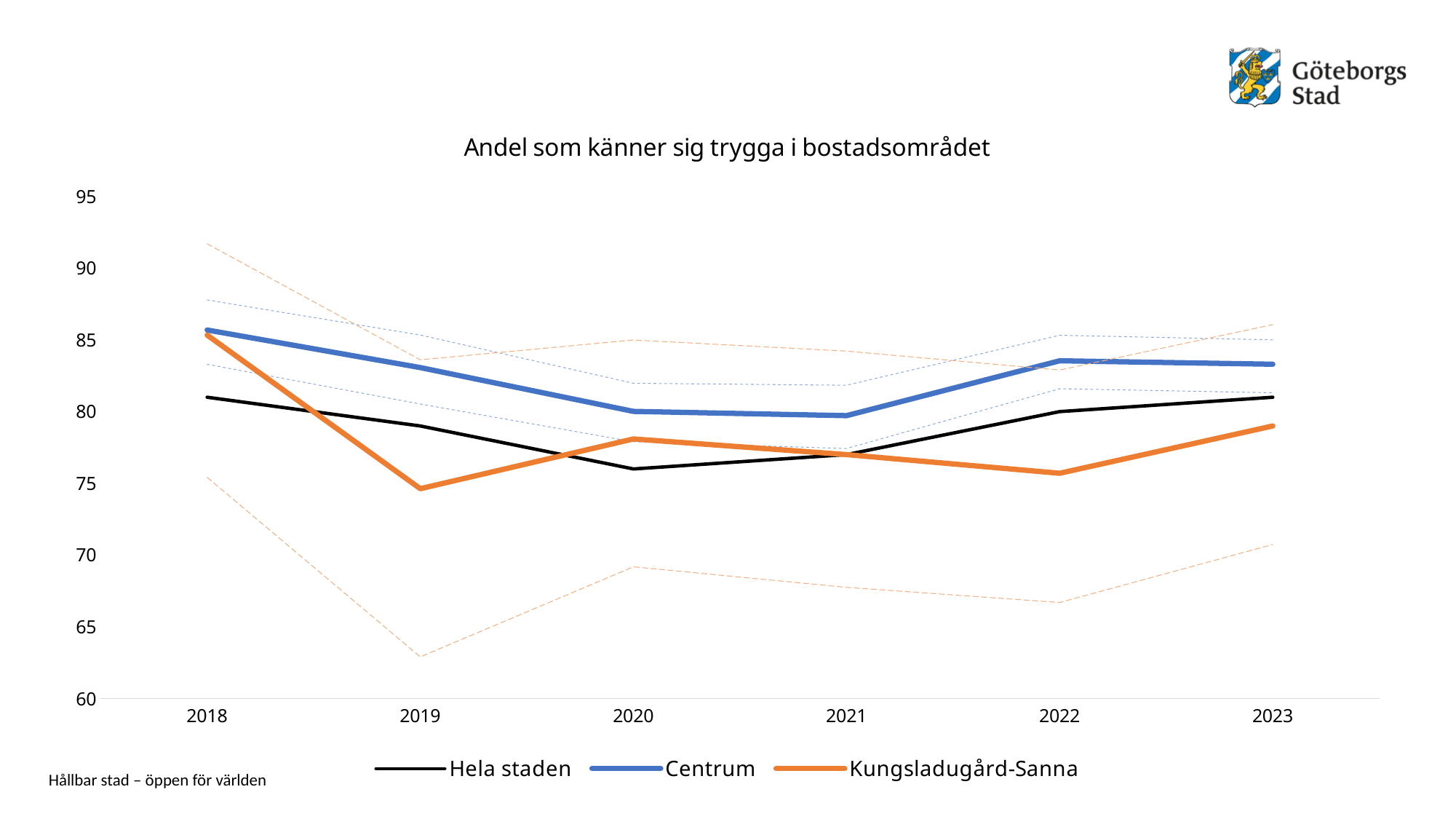
What is the title of the chart? Andel som känner sig trygga i bostadsområdet Is the value for Hela staden in 2020 greater or less than 80? less In which year is Kungsladugård-Sanna at its lowest? 2019 What kind of chart is shown on the slide? line chart In 2020, which is higher: Hela staden or Kungsladugård-Sanna? Kungsladugård-Sanna Is the value for Kungsladugård-Sanna in 2019 greater or less than 80? less Does the Hela staden line rise or fall from 2020 to 2023? rise How many years are shown on the x axis? 6 Which series has the highest value in 2023? Centrum How many series does the legend list? 3 Is the value for Centrum in 2018 greater or less than 80? greater Which series is drawn in orange? Kungsladugård-Sanna